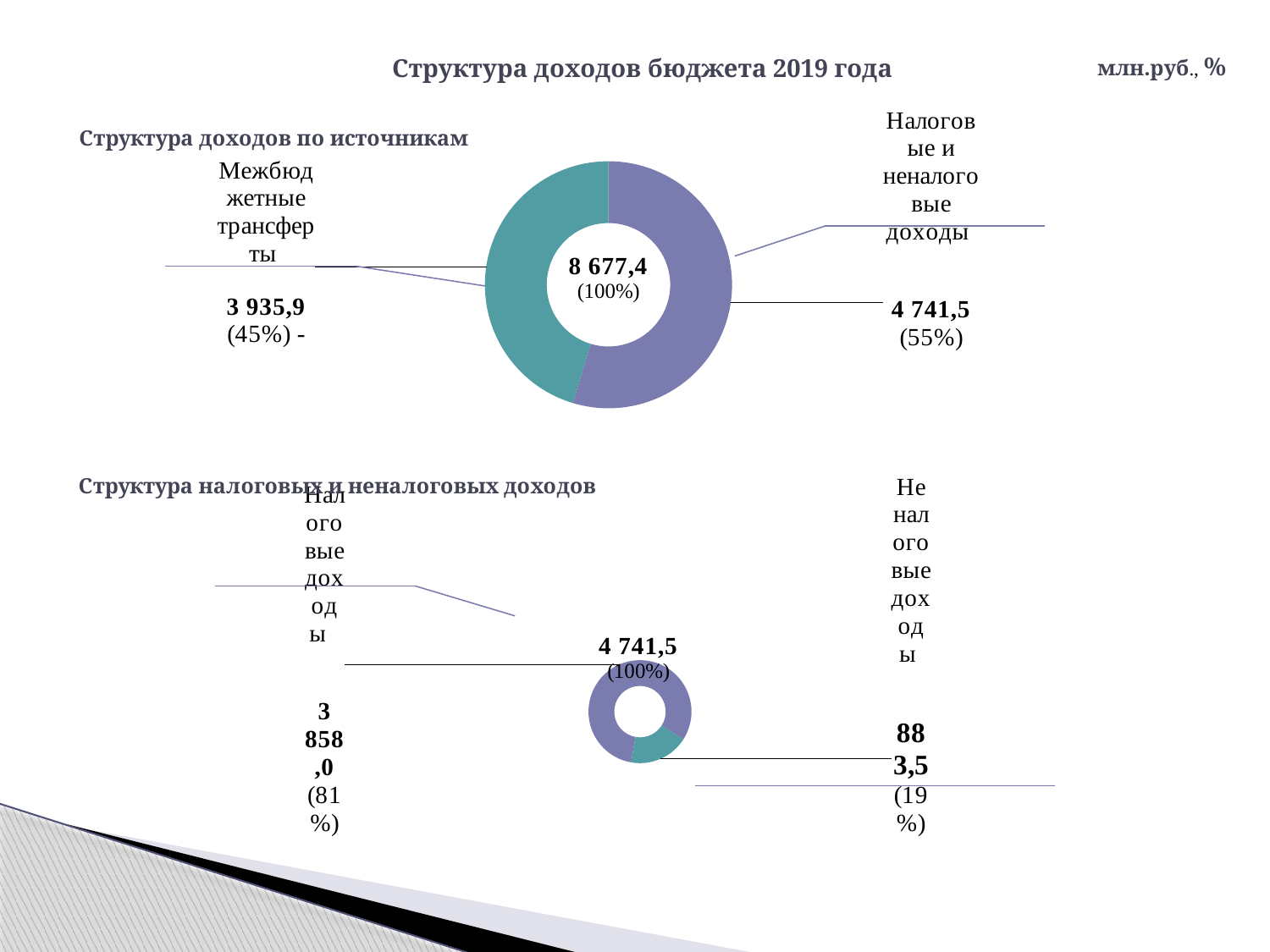
In the top chart 'Структура доходов по источникам', what is the difference between Налоговые и неналоговые доходы and Межбюджетные трансферты? 805,6 In the top chart 'Структура доходов по источникам', which category is larger: Межбюджетные трансферты or Налоговые и неналоговые доходы? Налоговые и неналоговые доходы In the bottom chart 'Структура налоговых и неналоговых доходов', what is the value for Неналоговые доходы? 883,5 In the bottom chart 'Структура налоговых и неналоговых доходов', which category is the smallest? Неналоговые доходы In the bottom chart 'Структура налоговых и неналоговых доходов', what share of the total do Неналоговые доходы make up? 19% In the top chart 'Структура доходов по источникам', what is the value for Межбюджетные трансферты? 3 935,9 How many categories does the bottom chart 'Структура налоговых и неналоговых доходов' show? 2 In the top chart 'Структура доходов по источникам', what share of the total do Межбюджетные трансферты make up? 45% What kind of chart is used in the top chart 'Структура доходов по источникам'? Donut (pie) chart In the bottom chart 'Структура налоговых и неналоговых доходов', what is the value for Налоговые доходы? 3 858,0 In the top chart 'Структура доходов по источникам', what is the total shown in the centre of the donut? 8 677,4 In the top chart 'Структура доходов по источникам', what is the value for Налоговые и неналоговые доходы? 4 741,5